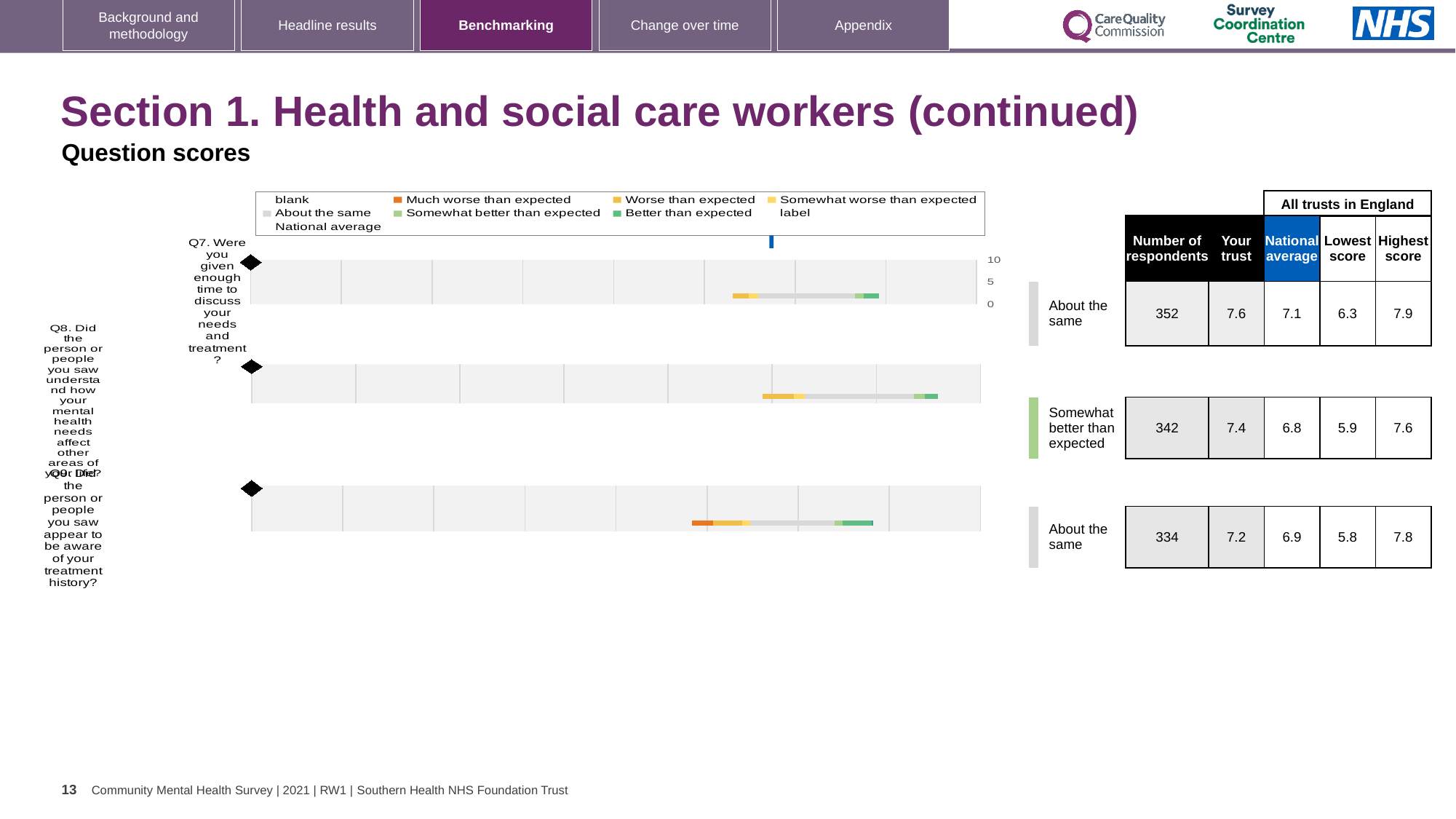
What is the difference between the highest score and the lowest score for Q9? 2.0 What is the difference between the 'Your trust' score and the national average for Q7? 0.5 Which question has the highest 'Your trust' score on this slide? Q7 How many questions are plotted on this slide? 3 What is the 'Your trust' score for Q8 (Did the person or people you saw understand how your mental health needs affect other areas of your life?)? 7.4 What is the lowest score across all trusts in England for Q8? 5.9 What is the highest score across all trusts in England for Q7? 7.9 What is the national average score for Q9 (Did the person or people you saw appear to be aware of your treatment history?)? 6.9 Which question has more respondents, Q7 or Q9? Q7 What benchmark category is given for Q8? Somewhat better than expected What kind of chart is used to show the question scores on this slide? Bar chart How many respondents are shown for Q7 (Were you given enough time to discuss your needs and treatment?)? 352